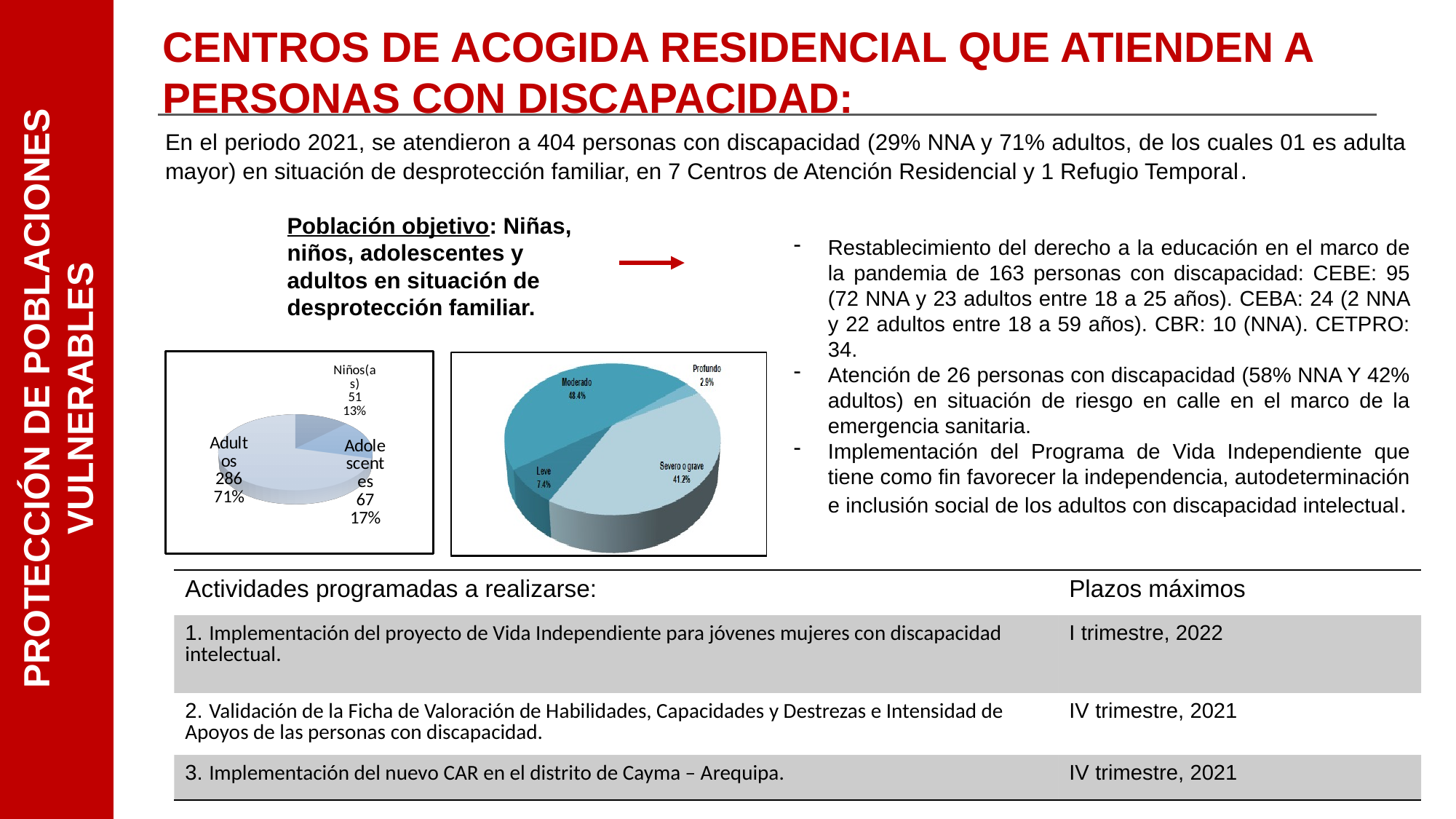
In the right pie chart, what percentage is shown for Moderado? 48.4% In the left pie chart, what percentage is shown for Niños(as)? 13% In the right pie chart, what percentage is shown for Severo o grave? 41.2% In the left pie chart, which category has the largest slice? Adultos In the left pie chart, what is the value shown for Adultos? 286 In the left pie chart, what is the difference between the values for Adultos and Adolescentes? 219 In the right pie chart, which is larger, Leve or Profundo? Leve In the right pie chart, which category has the smallest slice? Profundo What type of chart is the chart on the left? Pie chart How many categories does the left pie chart show? 3 In the left pie chart, which category has the smallest slice? Niños(as)